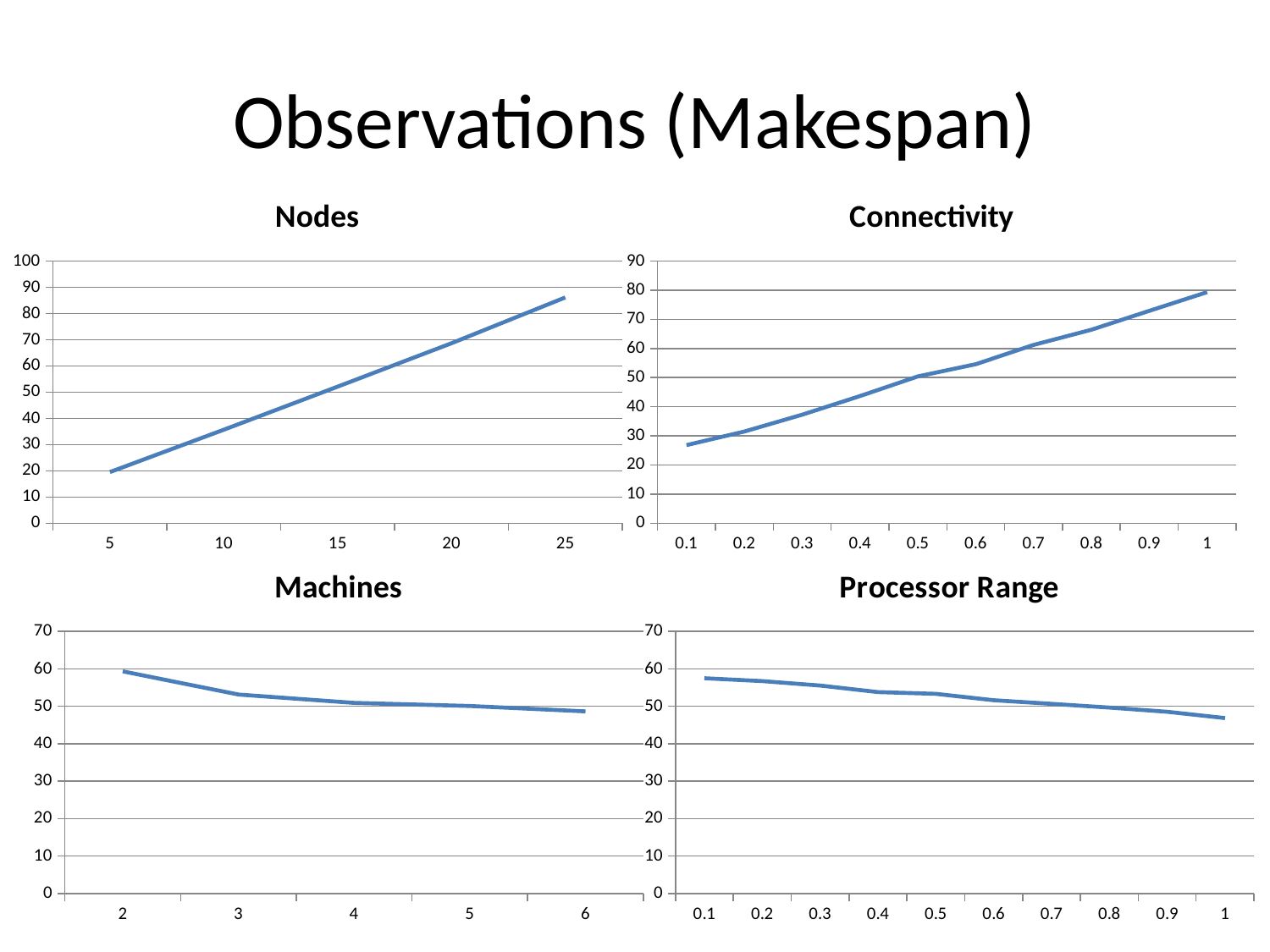
In the Nodes chart, is the value at x = 25 greater or less than 80? greater What kind of chart is the Nodes chart? line chart In the Nodes chart, do the values rise or fall as the x axis increases from 5 to 25? rise In the Processor Range chart, which is larger, the value at x = 0.1 or the value at x = 1? 0.1 In the Connectivity chart, is the value at x = 1 greater or less than 70? greater In the Machines chart, do the values rise or fall as the number of machines increases from 2 to 6? fall In the Processor Range chart, is the value at x = 1 greater or less than 50? less How many data points are plotted in the Connectivity chart? 10 How many data points are plotted in the Nodes chart? 5 In the Machines chart, which x value has the highest plotted value? 2 In the Connectivity chart, do the values rise or fall as connectivity increases from 0.1 to 1? rise